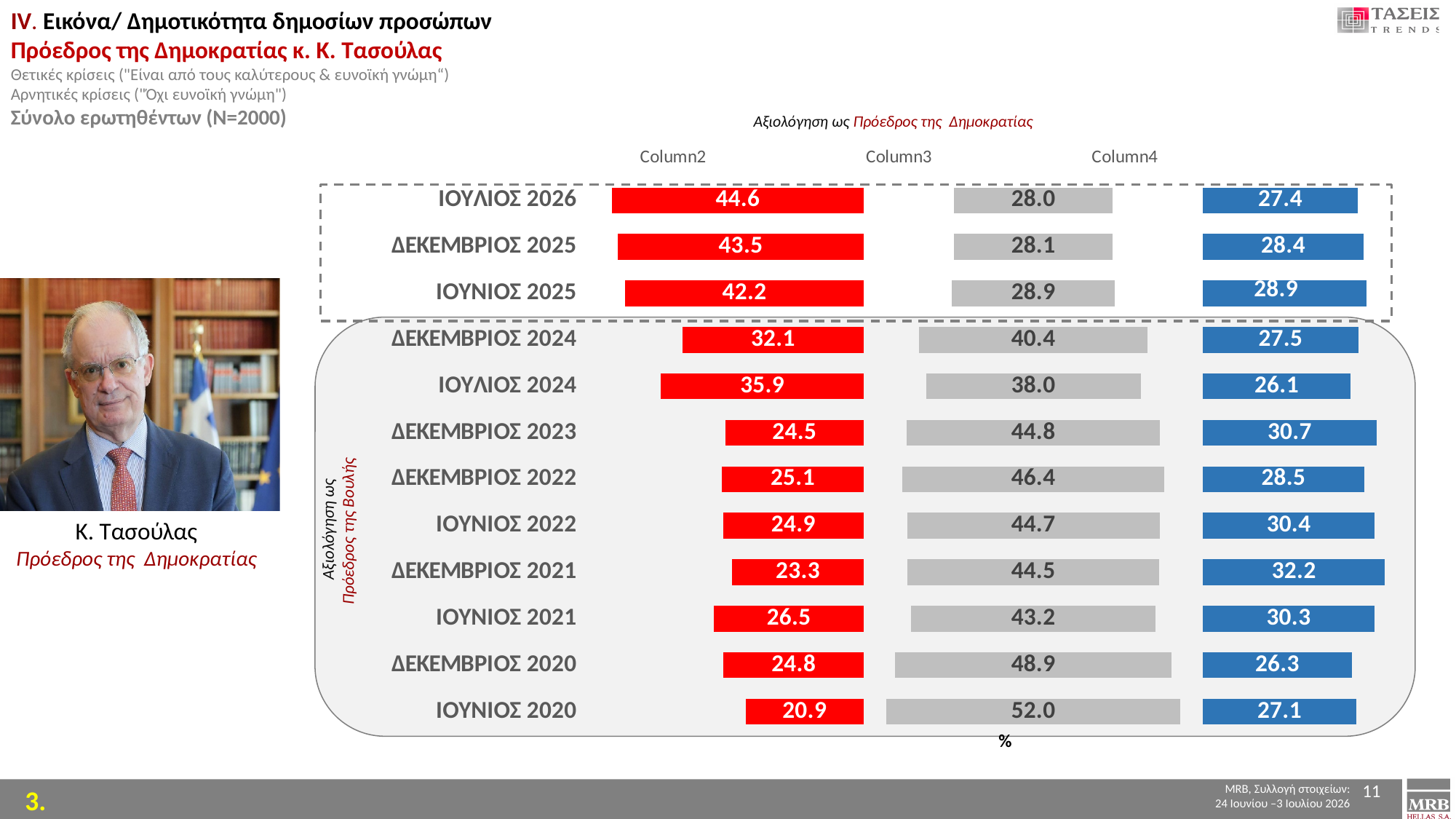
How many periods (categories) are shown in the chart? 12 What type of chart is shown on the slide? Bar chart What is the Column3 value for ΔΕΚΕΜΒΡΙΟΣ 2020? 48.9 Which period has the highest Column3 value? ΙΟΥΝΙΟΣ 2020 What is the Column4 value for ΙΟΥΝΙΟΣ 2022? 30.4 What is the difference between the Column3 values for ΙΟΥΝΙΟΣ 2020 and ΙΟΥΛΙΟΣ 2026? 24.0 What is the difference between the Column2 values for ΙΟΥΛΙΟΣ 2026 and ΔΕΚΕΜΒΡΙΟΣ 2024? 12.5 Which period has the highest Column4 value? ΔΕΚΕΜΒΡΙΟΣ 2021 How many series does the chart show? 3 Which period has the lowest Column2 value? ΙΟΥΝΙΟΣ 2020 Which is larger for ΔΕΚΕΜΒΡΙΟΣ 2023: the Column2 value or the Column3 value? Column3 What is the Column2 value for ΙΟΥΛΙΟΣ 2026? 44.6